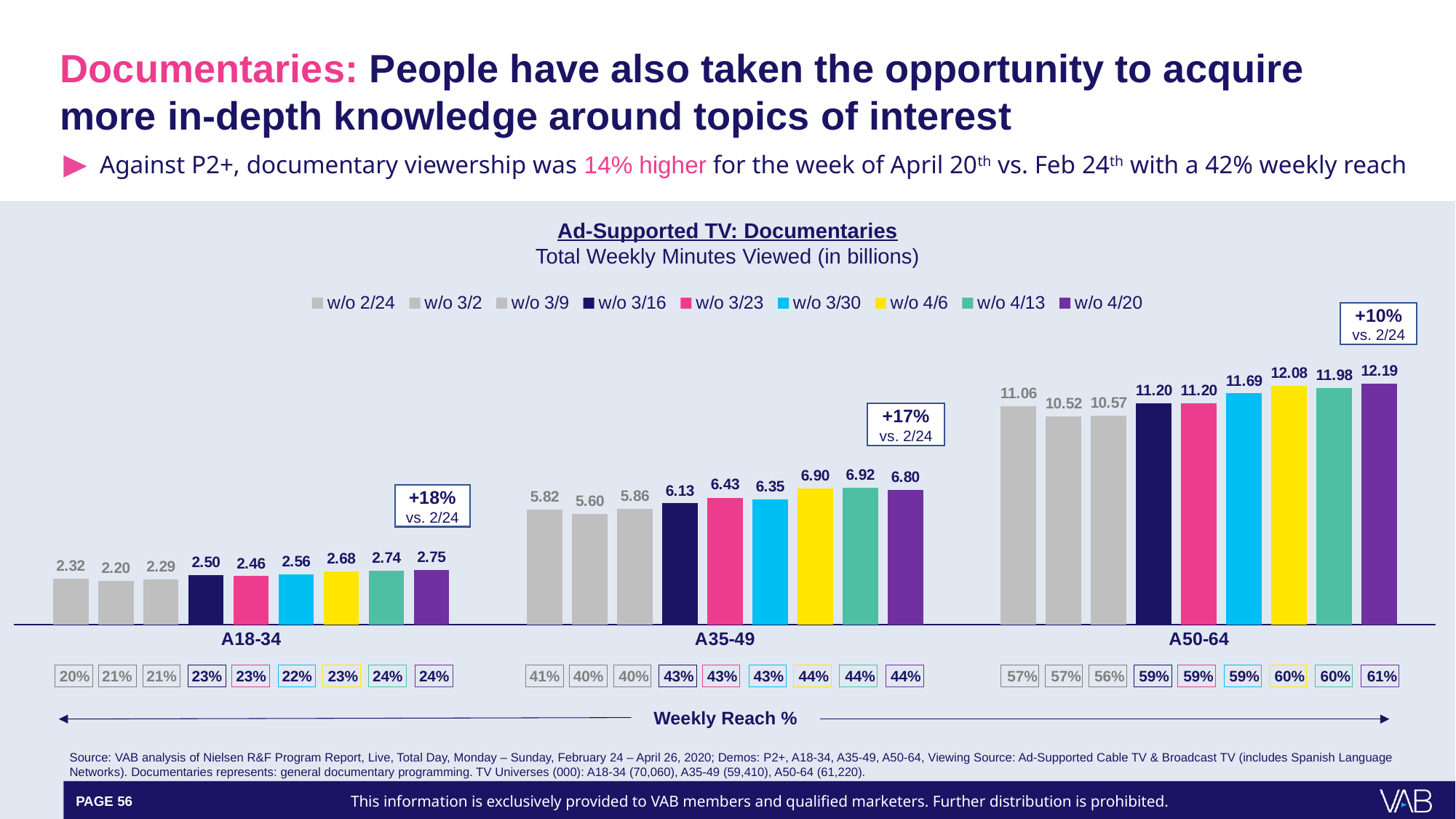
How many demographic groups are shown on the x axis? 3 What is the value for w/o 3/2 in the A18-34 group? 2.20 What is the weekly reach % for w/o 4/20 in the A50-64 group? 61% What is the percentage change vs. 2/24 shown in the callout above the A35-49 group? +17% What kind of chart is shown on the slide? Bar chart What is the value for w/o 4/20 in the A50-64 group? 12.19 Which week has the lowest value in the A50-64 group? w/o 3/2 How many series does the legend list? 9 Which week has the highest value in the A35-49 group? w/o 4/13 What is the difference between the w/o 4/20 and w/o 2/24 values in the A18-34 group? 0.43 Which is larger in the A50-64 group: w/o 4/6 or w/o 4/13? w/o 4/6 What is the value for w/o 2/24 in the A35-49 group? 5.82